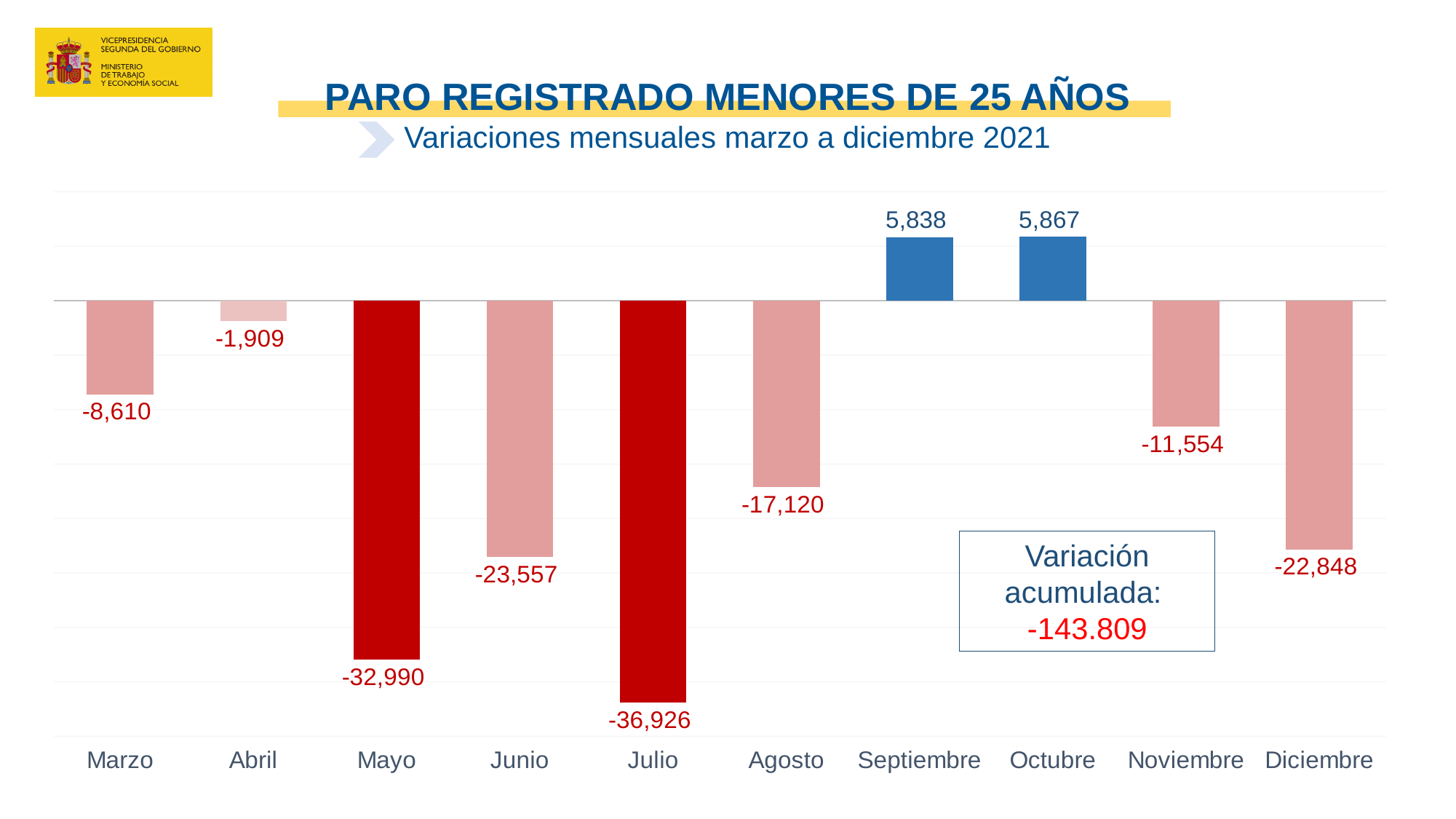
Which month has the lowest value? Julio What is the difference between the values for Octubre and Septiembre? 29 What is the value for Septiembre? 5,838 What is the value for Abril? -1,909 How many months are shown on the chart? 10 What is the difference between the values for Mayo and Julio? 3,936 What is the 'Variación acumulada' shown in the box on the chart? -143.809 Which month has the highest value? Octubre What kind of chart is shown on the slide? Bar chart Which is larger, the value for Junio or the value for Agosto? Agosto What is the value for Julio? -36,926 What is the value for Diciembre? -22,848